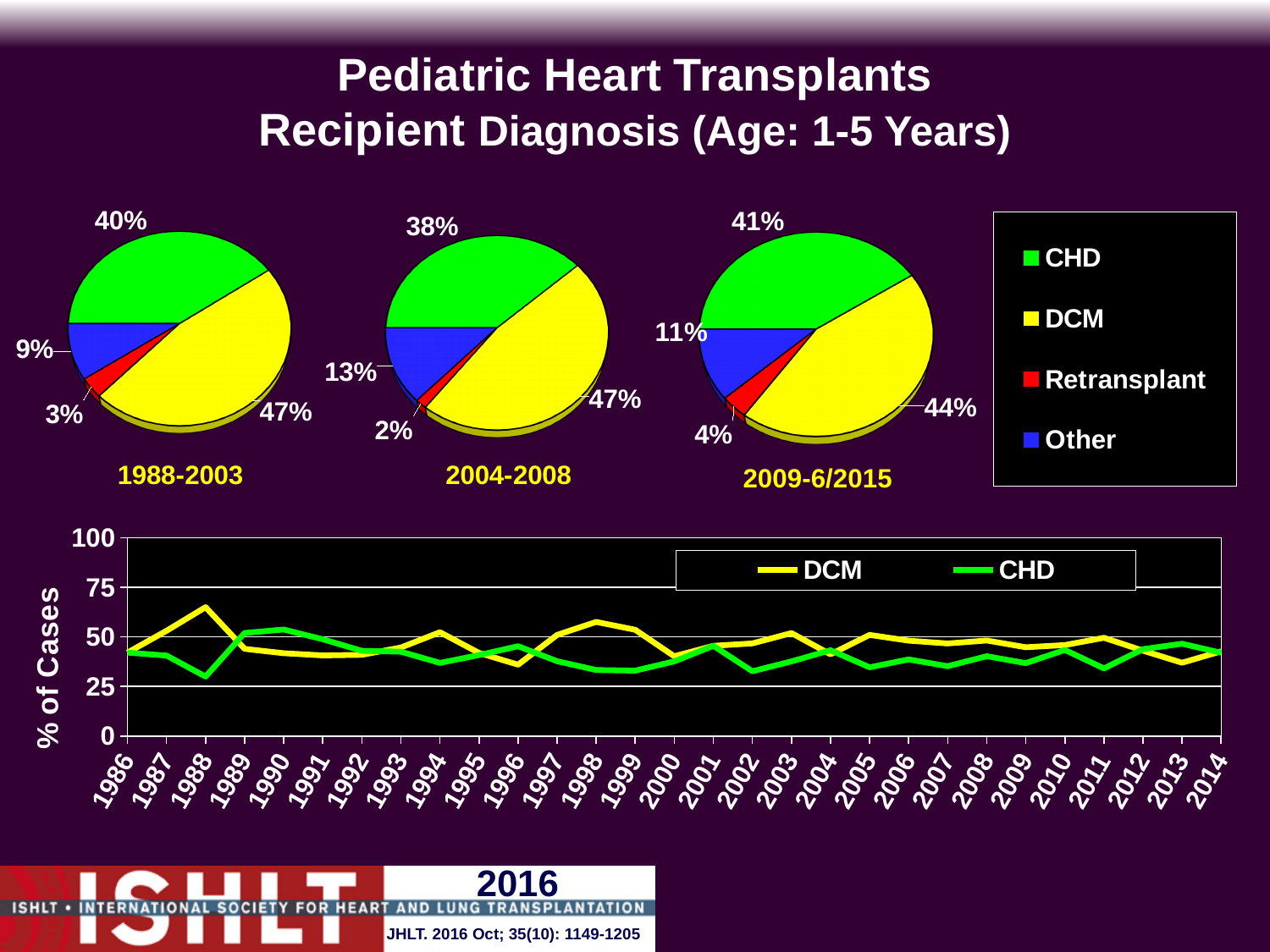
In the 2004-2008 pie chart, what share of cases is Other? 13% In the bottom line chart, is the CHD value for 1988 greater or less than 50? less In the 2009-6/2015 pie chart, which diagnosis has the largest share? DCM In the 1988-2003 pie chart, what is the difference between the DCM share and the CHD share? 7% In the 2009-6/2015 pie chart, what share of cases is Retransplant? 4% In the 1988-2003 pie chart, what share of cases is DCM? 47% How many series does the legend of the pie charts list? 4 In the 2004-2008 pie chart, which diagnosis has the smallest share? Retransplant How many years are shown on the x axis of the bottom line chart? 29 What kind of chart is the bottom chart showing % of Cases by year? Line chart In the 2009-6/2015 pie chart, which is larger, the CHD share or the Other share? CHD In the bottom line chart, is the DCM value for 1988 greater or less than 50? greater